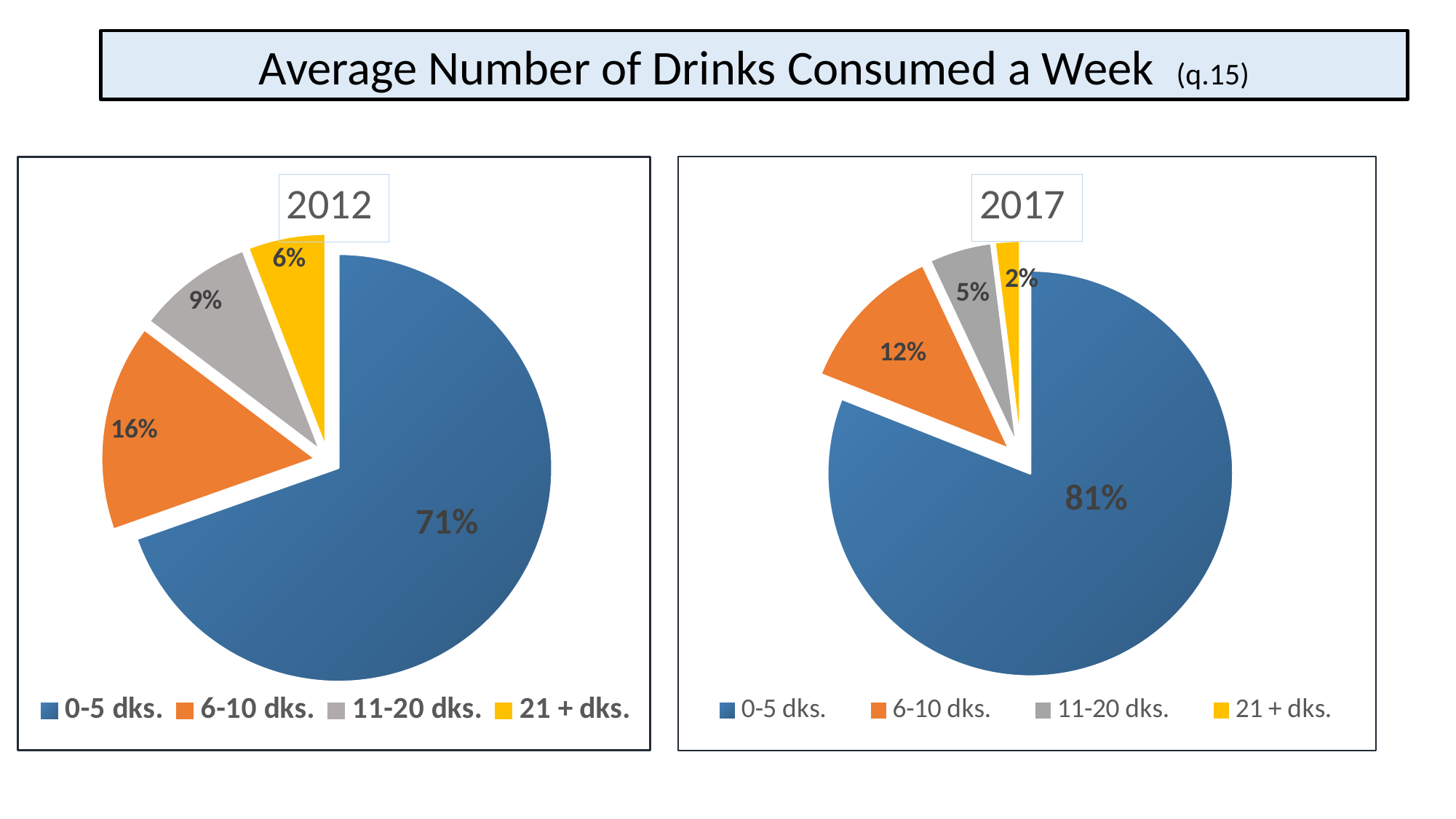
What is the difference between the 0-5 dks. share in 2017 and the 0-5 dks. share in 2012? 10% In the 2012 pie chart, what percentage is shown for 0-5 dks.? 71% Which is larger: the 11-20 dks. share in 2012 or the 11-20 dks. share in 2017? 2012 What type of chart is used for the 2012 data? Pie chart In the 2012 pie chart, which category has the smallest slice? 21 + dks. What colour represents the 21 + dks. category in the legends? Yellow In the 2012 pie chart, what percentage is shown for 11-20 dks.? 9% In the 2017 pie chart, what percentage is shown for 21 + dks.? 2% In the 2012 pie chart, what is the difference between the 6-10 dks. slice and the 21 + dks. slice? 10% In the 2017 pie chart, what percentage is shown for 6-10 dks.? 12% How many slices does the 2017 pie chart have? 4 In the 2017 pie chart, which category has the largest slice? 0-5 dks.